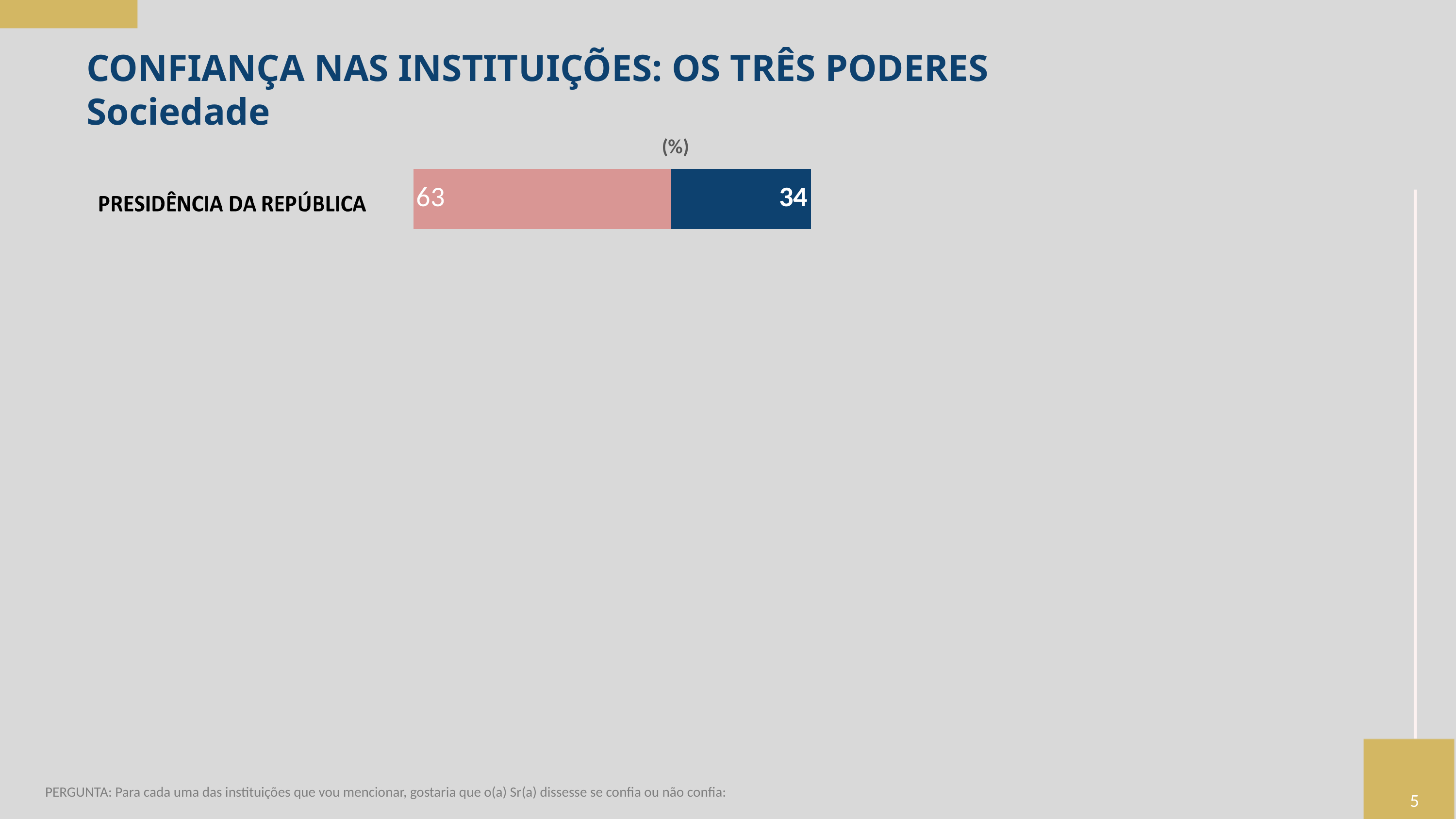
What is the difference between the pink segment value (63) and the dark blue segment value (34) for PRESIDÊNCIA DA REPÚBLICA? 29 What kind of chart is shown on the slide? bar chart Which institution is labelled on the chart? PRESIDÊNCIA DA REPÚBLICA What value is shown on the dark blue segment of the bar for PRESIDÊNCIA DA REPÚBLICA? 34 How many institutions (categories) are plotted in the chart? 1 What is the total of the two segments in the PRESIDÊNCIA DA REPÚBLICA bar? 97 What unit label is shown above the chart? (%) Which segment of the PRESIDÊNCIA DA REPÚBLICA bar is larger, the pink one or the dark blue one? the pink one What value is shown on the pink segment of the bar for PRESIDÊNCIA DA REPÚBLICA? 63 Is the value of the dark blue segment for PRESIDÊNCIA DA REPÚBLICA greater or less than 50? less Is the value of the pink segment for PRESIDÊNCIA DA REPÚBLICA greater or less than 50? greater